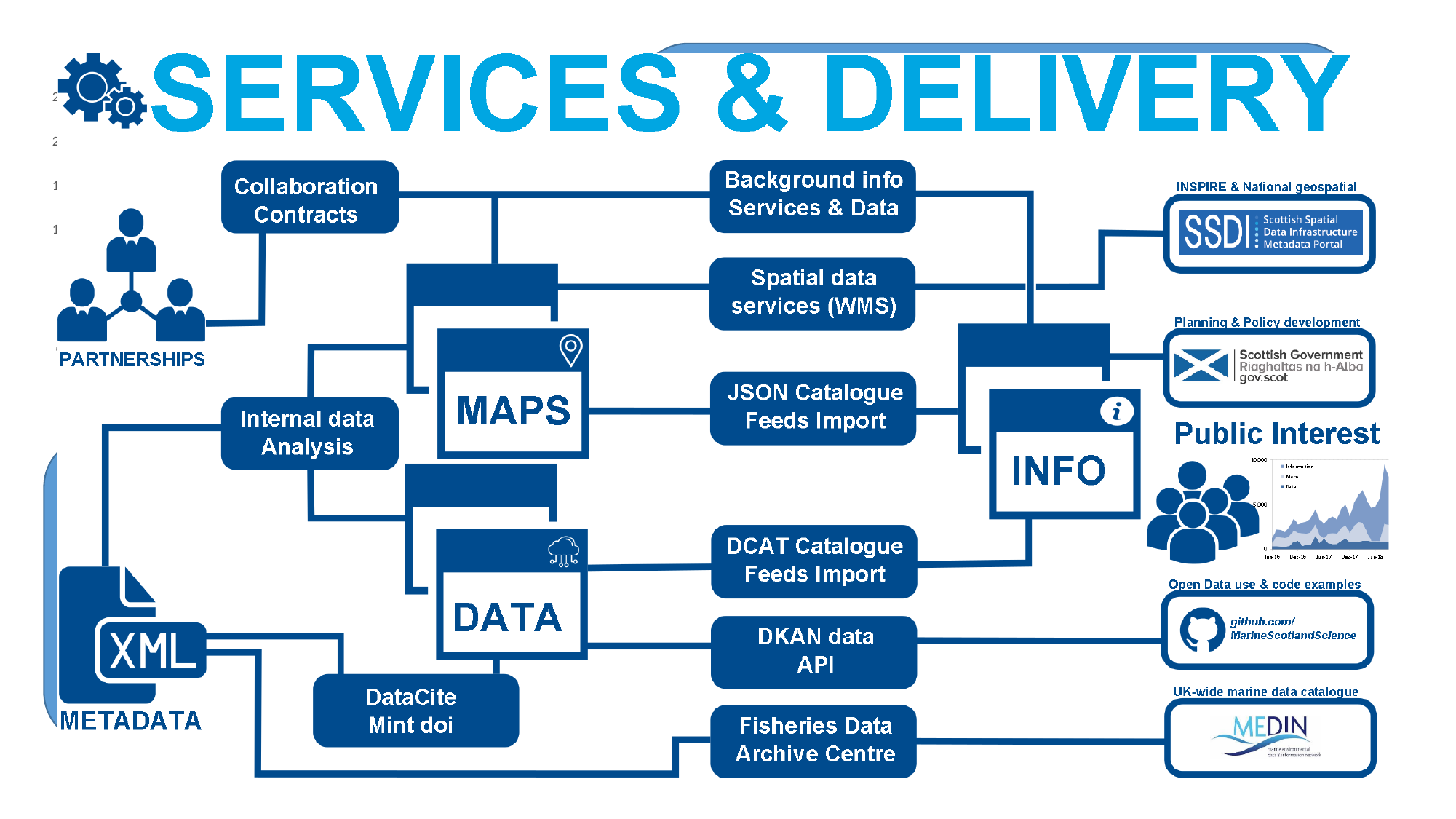
How many series does the legend of the Public Interest chart list? 3 What is the first date labelled on the x axis of the Public Interest chart? Jun-16 What is the highest value labelled on the y axis of the Public Interest chart? 10,000 In the Public Interest chart, do the values generally rise or fall from Jun-16 to Jun-18? rise How many date labels are shown on the x axis of the Public Interest chart? 5 What kind of chart is shown in the Public Interest section of the slide? area chart